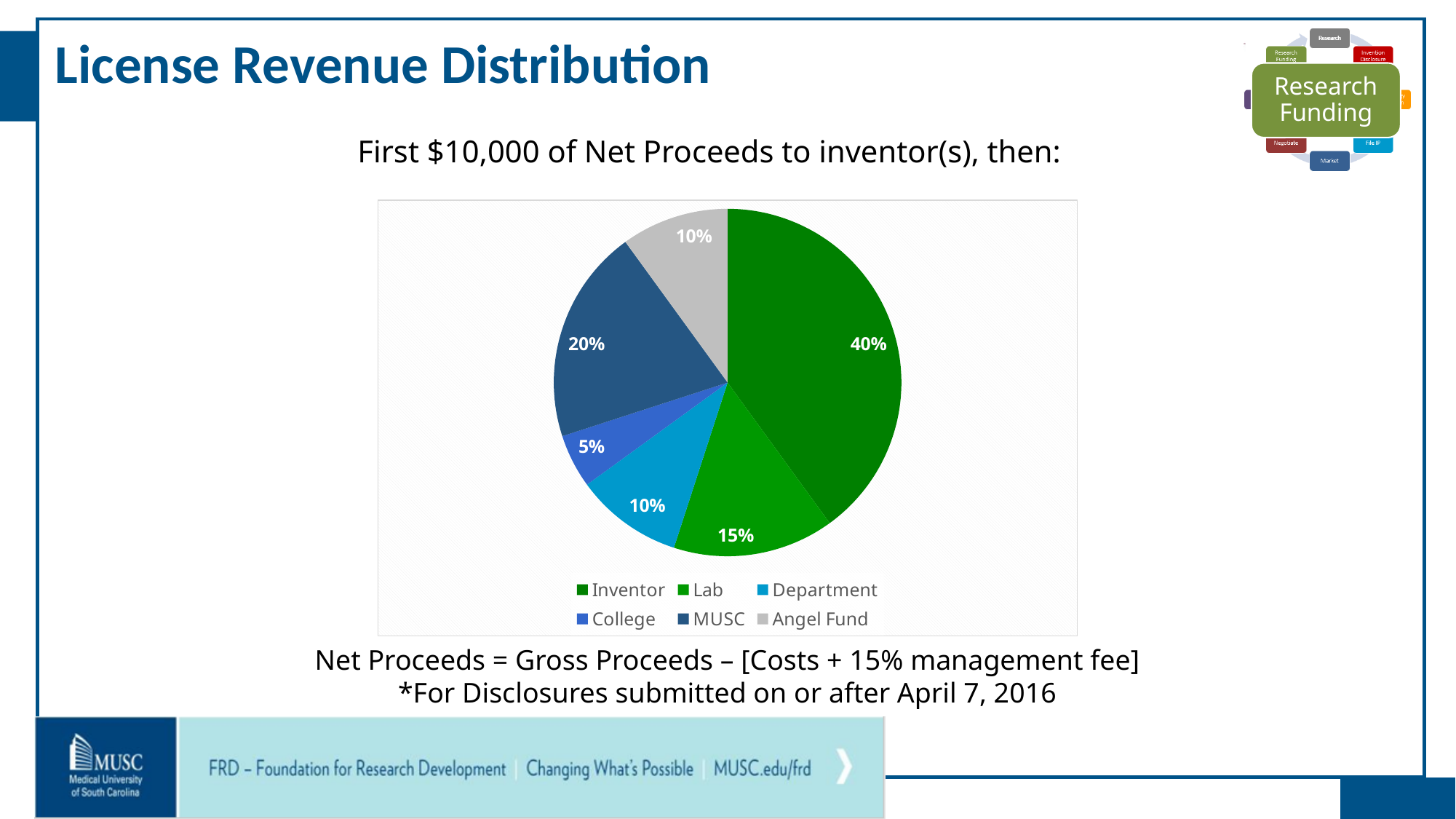
What share of the pie does College receive? 5% What share of the pie does MUSC receive? 20% What share of the pie does Angel Fund receive? 10% Which category has the smallest slice of the pie? College How many categories does the legend list? 6 Which legend entry is shown in gray? Angel Fund What is the difference between the Inventor share and the MUSC share? 20% Which is larger, the Lab share or the Department share? Lab What share of the pie does Lab receive? 15% Which category has the largest slice of the pie? Inventor What type of chart is shown on the slide? pie chart What share of the pie does Inventor receive? 40%